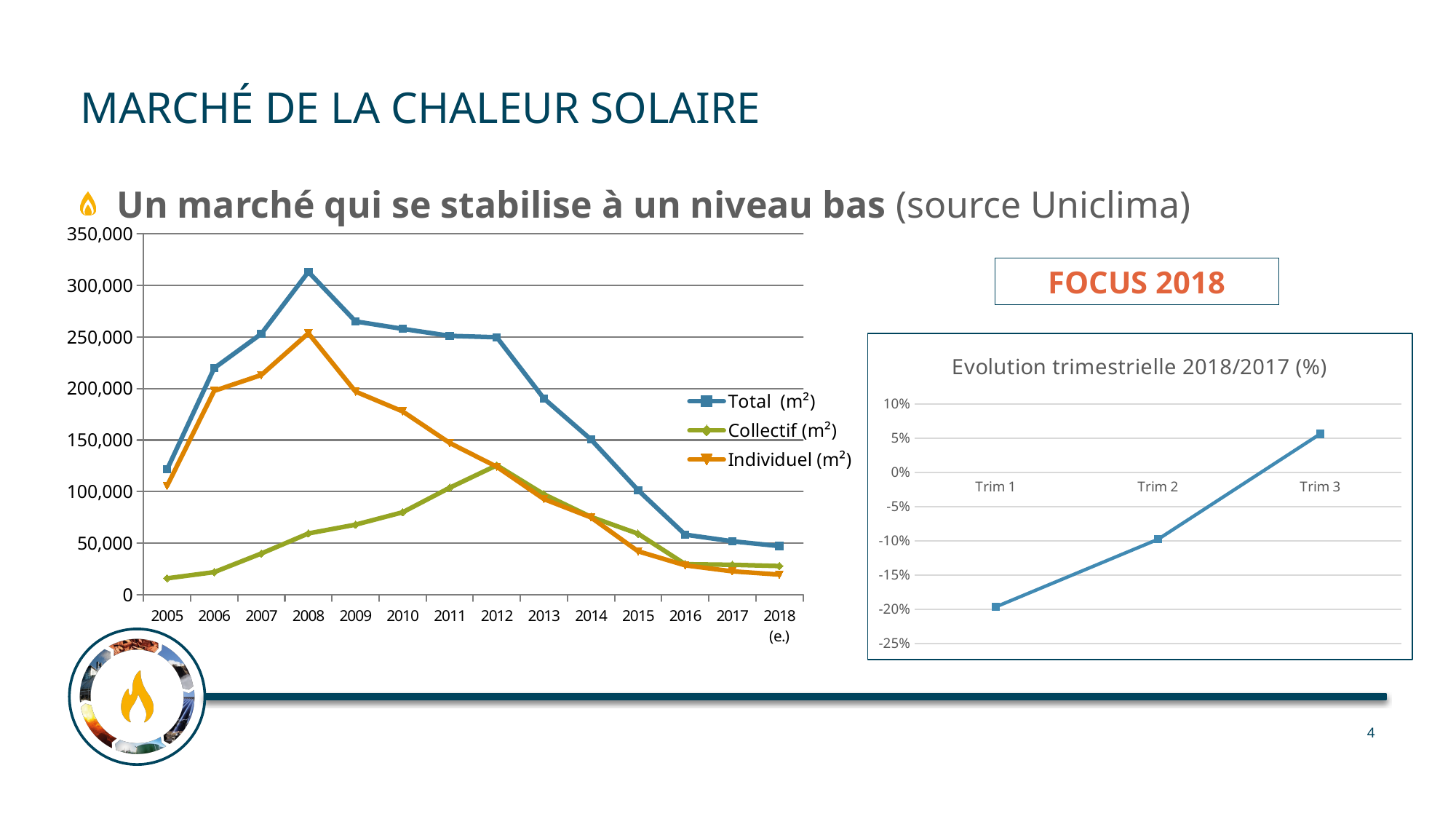
On the left chart, in which year does the Total (m²) series reach its highest value? 2008 On the chart titled 'Evolution trimestrielle 2018/2017 (%)', which quarter has the lowest value? Trim 1 On the left chart, how many years are shown on the x axis? 14 On the chart titled 'Evolution trimestrielle 2018/2017 (%)', is the value for Trim 1 greater or less than -15%? less On the left chart, is the Total (m²) value for 2008 greater or less than 300,000? greater On the left chart, in which year does the Collectif (m²) series reach its highest value? 2012 On the left chart, does the Total (m²) series rise or fall between 2012 and 2018? fall On the left chart, is the Collectif (m²) value for 2005 greater or less than 50,000? less What kind of chart is 'Evolution trimestrielle 2018/2017 (%)'? line chart On the left chart, which is larger in 2010: Collectif (m²) or Individuel (m²)? Individuel (m²) On the left chart, how many series does the legend list? 3